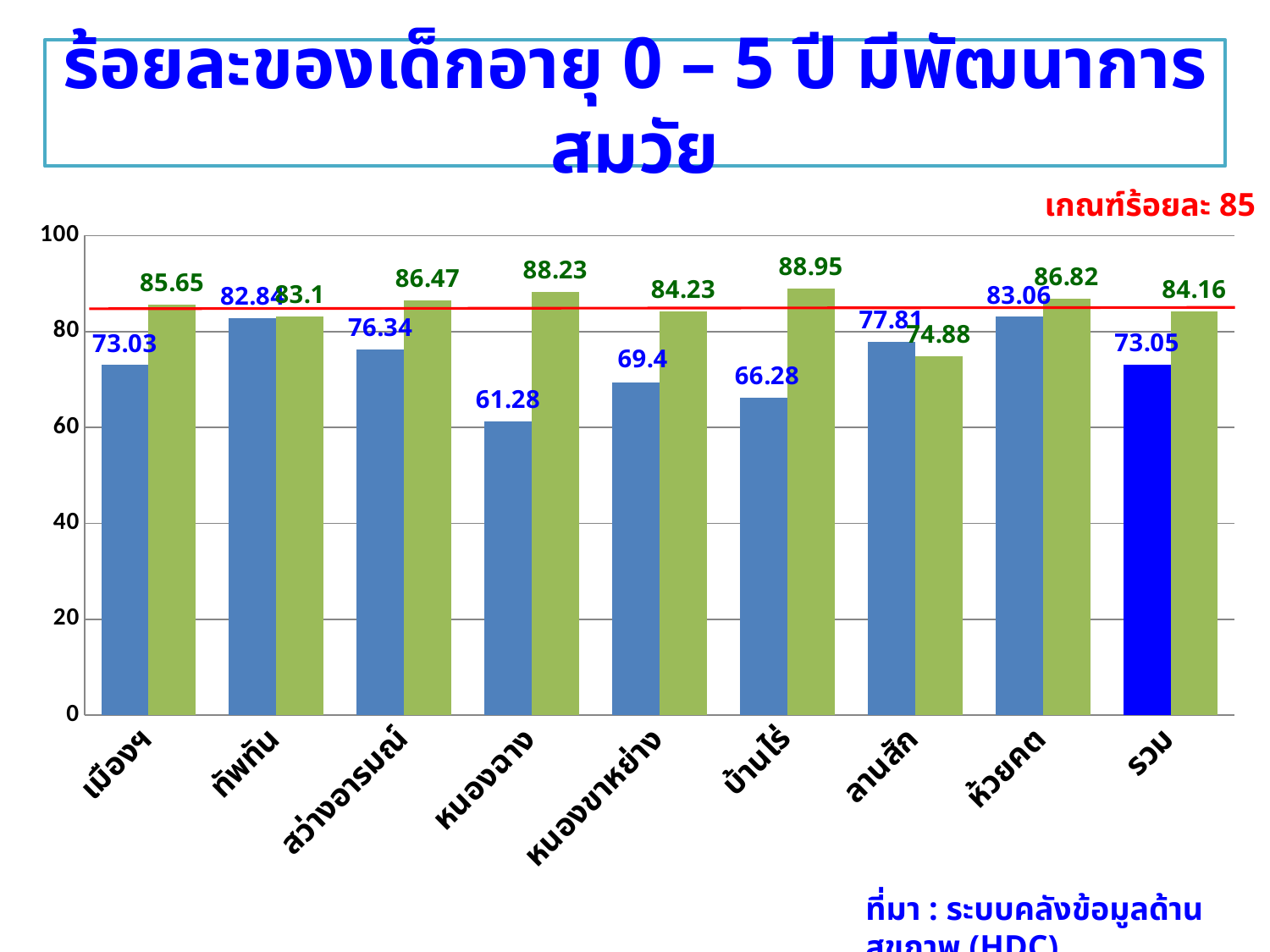
What kind of chart is shown on the slide? bar chart Which category has the lowest green bar? ลานสัก How many categories are shown on the x axis? 9 Which category has the lowest blue bar? หนองฉาง What is the value of the blue bar for หนองฉาง? 61.28 What threshold value is indicated by the red line label (เกณฑ์ร้อยละ)? 85 What is the value of the green bar for บ้านไร่? 88.95 Which category has the highest green bar? บ้านไร่ What is the difference between the green bar and the blue bar for หนองฉาง? 26.95 What is the value of the blue bar for ห้วยคต? 83.06 Which is larger for ลานสัก, the blue bar or the green bar? the blue bar What is the value of the green bar for รวม? 84.16